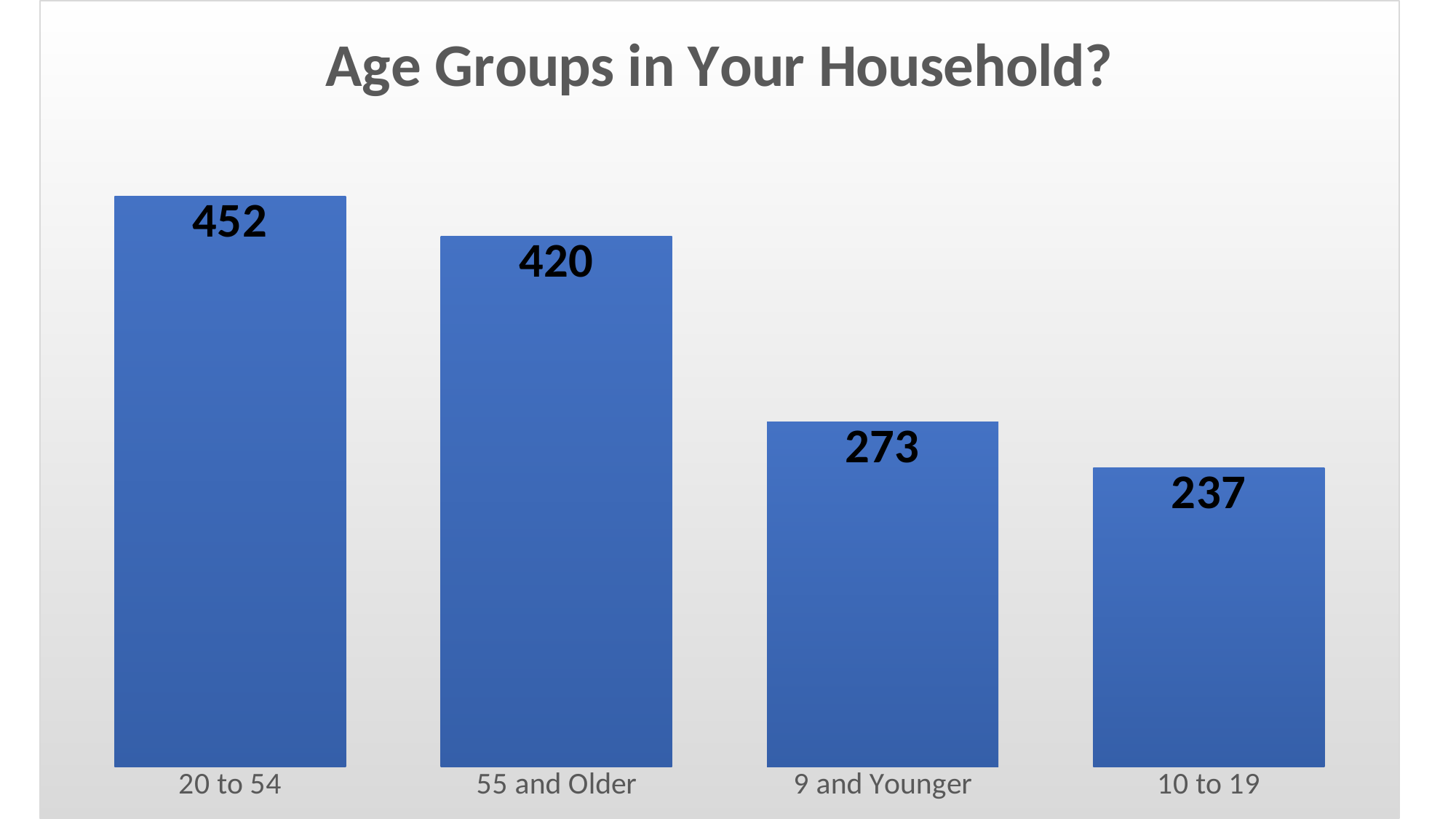
What is the difference between the values for 20 to 54 and 55 and Older? 32 What is the difference between the values for 9 and Younger and 10 to 19? 36 Which is larger, the value for 55 and Older or the value for 9 and Younger? 55 and Older What is the value for the 9 and Younger age group? 273 What kind of chart is shown on the slide? Bar chart What is the value for the 20 to 54 age group? 452 What is the title of the chart? Age Groups in Your Household? Which age group has the highest value? 20 to 54 How many age groups are shown in the chart? 4 What is the value for the 10 to 19 age group? 237 What is the value for the 55 and Older age group? 420 Which age group has the lowest value? 10 to 19